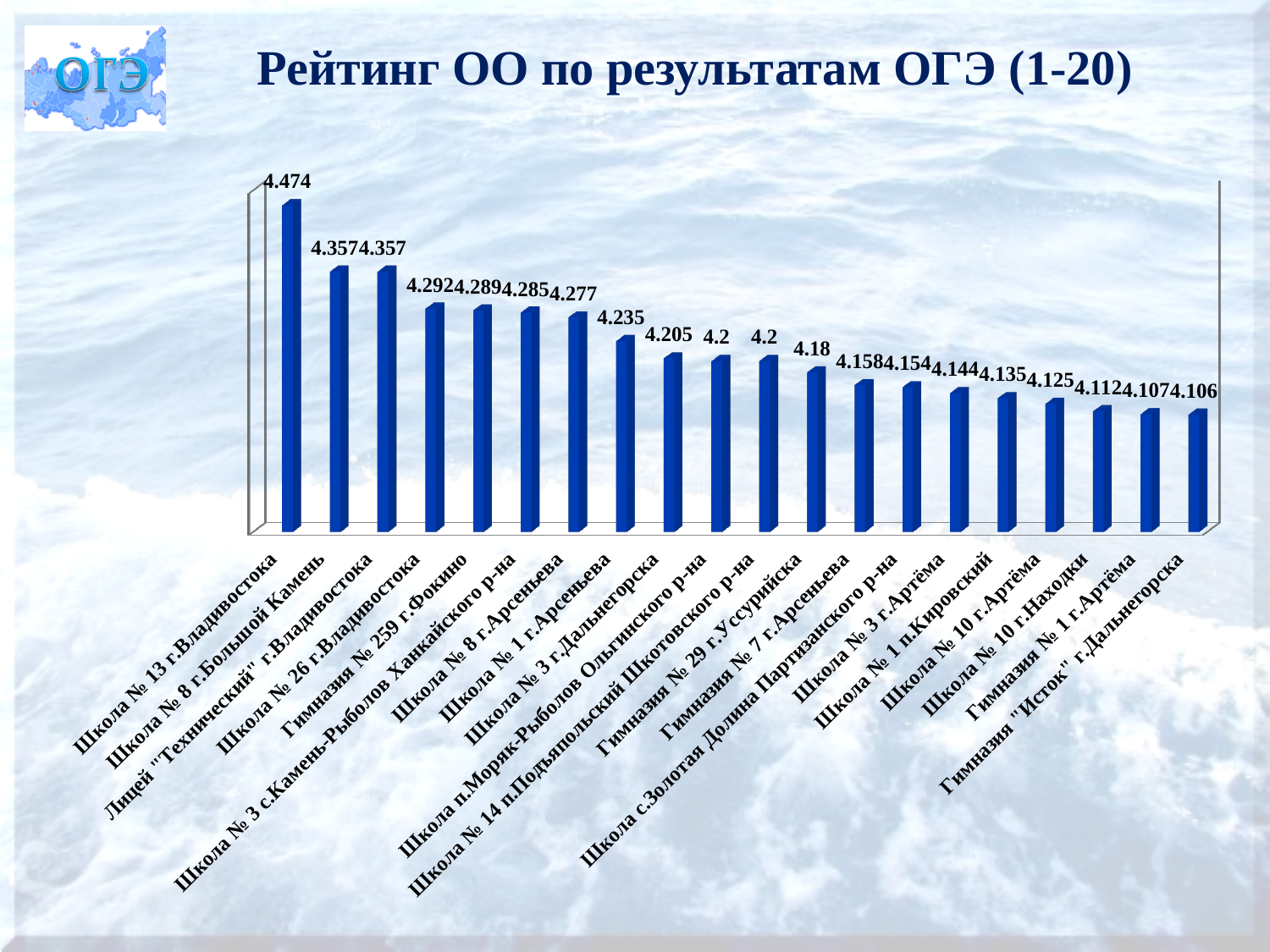
What is the value for Гимназия № 29 г.Уссурийска? 4.18 What is the value for Школа № 13 г.Владивостока? 4.474 Do the values rise or fall from left to right along the x axis? Fall How many schools are shown on the chart? 20 What kind of chart is shown on the slide? Bar chart What is the difference between the values for Школа № 1 г.Арсеньева and Школа № 3 г.Дальнегорска? 0.03 Which school has the highest value on the chart? Школа № 13 г.Владивостока Which has the larger value, Школа № 26 г.Владивостока or Школа № 3 г.Артёма? Школа № 26 г.Владивостока What is the difference between the values for Школа № 13 г.Владивостока and Школа № 8 г.Большой Камень? 0.117 What is the value for Гимназия "Исток" г.Дальнегорска? 4.106 Which school has the lowest value on the chart? Гимназия "Исток" г.Дальнегорска What is the value for Школа № 1 п.Кировский? 4.135